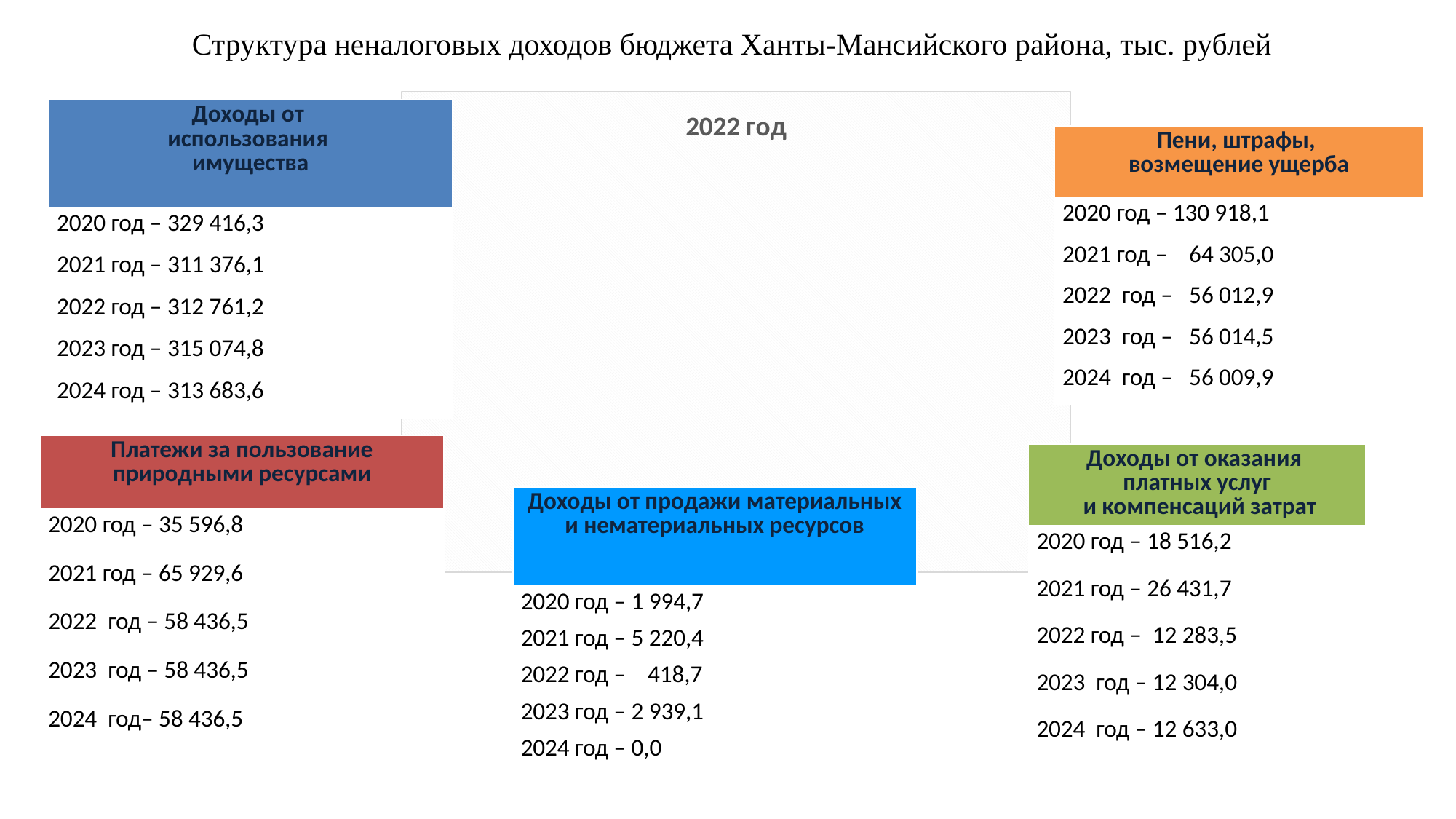
For 2022 год, which is larger: Платежи за пользование природными ресурсами or Пени, штрафы, возмещение ущерба? Платежи за пользование природными ресурсами How many income categories are shown on the slide? 5 Do the values for Пени, штрафы, возмещение ущерба rise or fall from 2020 год to 2024 год? fall How many years are listed for each income category? 5 What is the difference between the 2020 год and 2021 год values for Пени, штрафы, возмещение ущерба? 66 613,1 What title is shown inside the chart area on the slide? 2022 год What is the value for Доходы от использования имущества in 2022 год? 312 761,2 What is the value for Пени, штрафы, возмещение ущерба in 2020 год? 130 918,1 What is the value for Доходы от оказания платных услуг и компенсаций затрат in 2023 год? 12 304,0 Which income category has the lowest value for 2022 год? Доходы от продажи материальных и нематериальных ресурсов Which income category has the highest value for 2022 год? Доходы от использования имущества What is the value for Доходы от продажи материальных и нематериальных ресурсов in 2024 год? 0,0